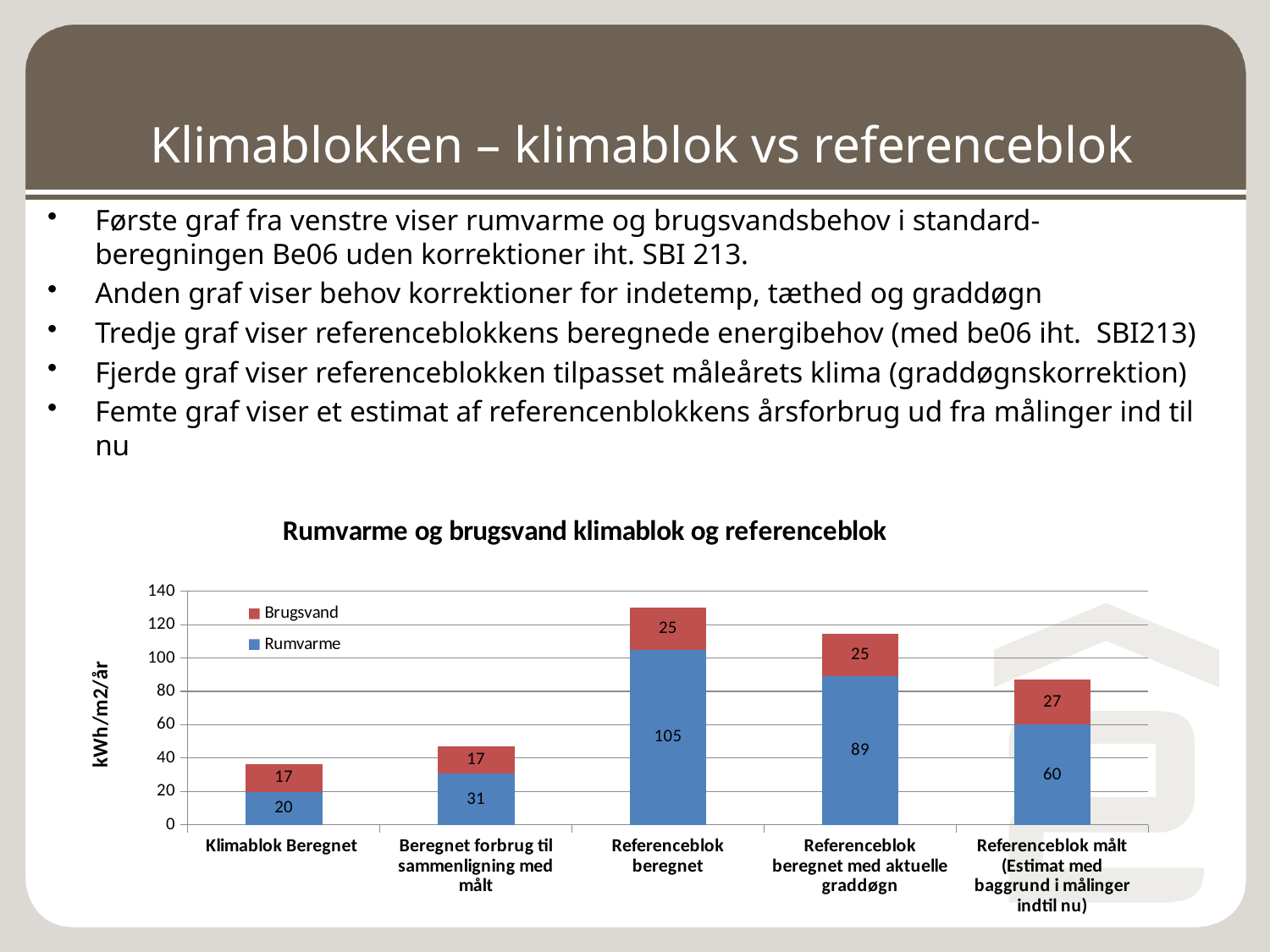
How many categories are shown on the x axis? 5 What is the Brugsvand value for Referenceblok målt (Estimat med baggrund i målinger indtil nu)? 27 What is the Rumvarme value for Referenceblok beregnet? 105 What is the Rumvarme value for Beregnet forbrug til sammenligning med målt? 31 What is the total of the stacked bar for Referenceblok beregnet? 130 Which category has the lowest Rumvarme value? Klimablok Beregnet What is the difference between the Rumvarme values for Referenceblok beregnet and Referenceblok beregnet med aktuelle graddøgn? 16 Which category has the highest Rumvarme value? Referenceblok beregnet What is the total of the stacked bar for Klimablok Beregnet? 37 Which is larger, the Rumvarme value for Klimablok Beregnet or for Beregnet forbrug til sammenligning med målt? Beregnet forbrug til sammenligning med målt How many series does the legend list? 2 What kind of chart is shown on the slide? Stacked bar chart